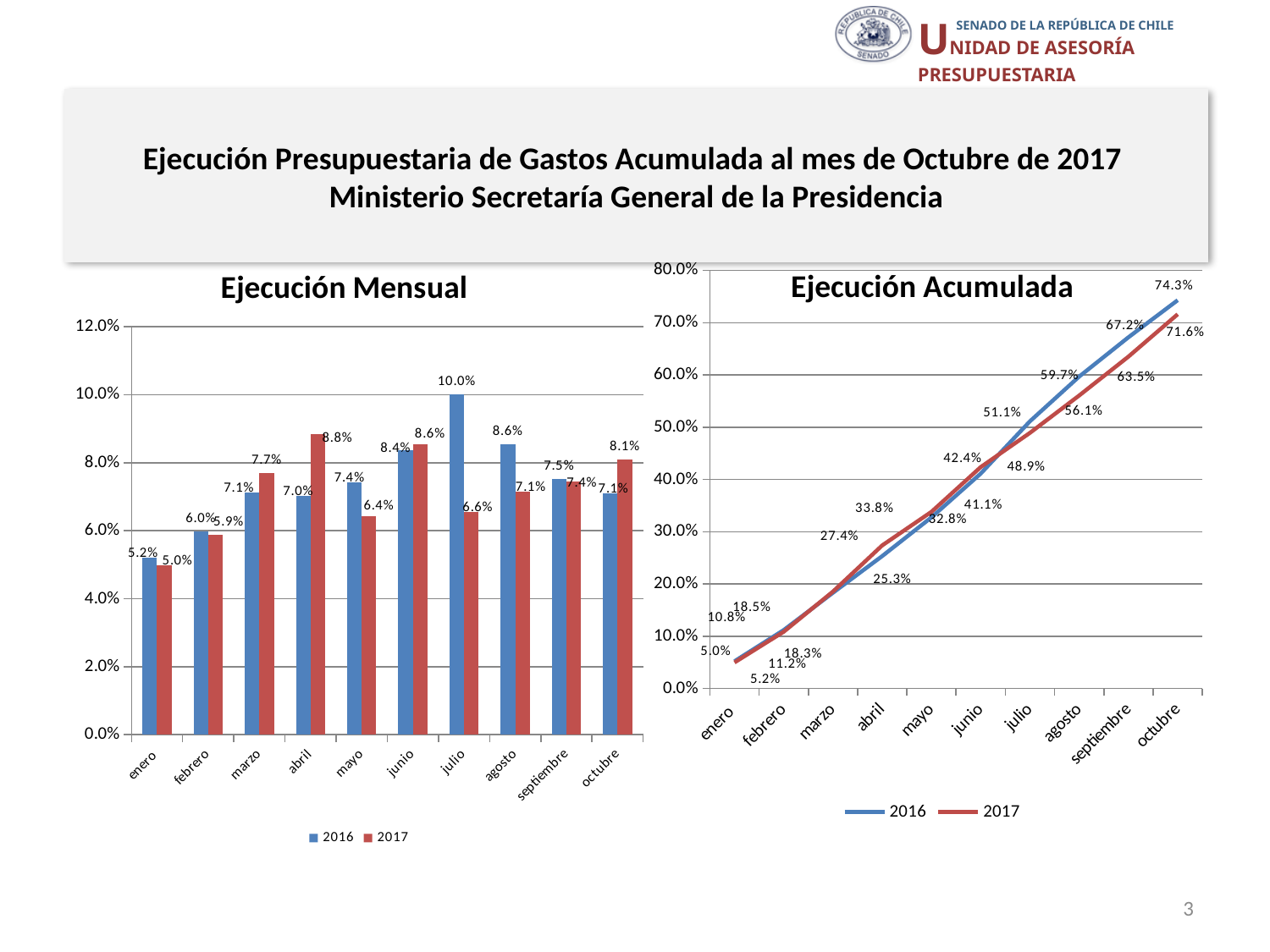
In the "Ejecución Mensual" chart, which month has the lowest value for 2017? enero In the "Ejecución Mensual" chart, what is the difference between the 2016 and 2017 values in julio? 3.4 percentage points In the "Ejecución Mensual" chart, which series has the larger value in mayo, 2016 or 2017? 2016 In the "Ejecución Acumulada" chart, do the values rise or fall from enero to octubre? rise How many series does the legend of the "Ejecución Acumulada" chart list? 2 What kind of chart is the "Ejecución Mensual" chart on the left? bar chart How many months are shown on the x axis of the "Ejecución Mensual" chart? 10 In the "Ejecución Mensual" chart, what is the value for 2017 in abril? 8.8% What kind of chart is the "Ejecución Acumulada" chart on the right? line chart In the "Ejecución Acumulada" chart, what is the value for 2016 in octubre? 74.3% In the "Ejecución Mensual" chart, which month has the highest value for 2016? julio In the "Ejecución Mensual" chart, what is the value for 2016 in julio? 10.0%